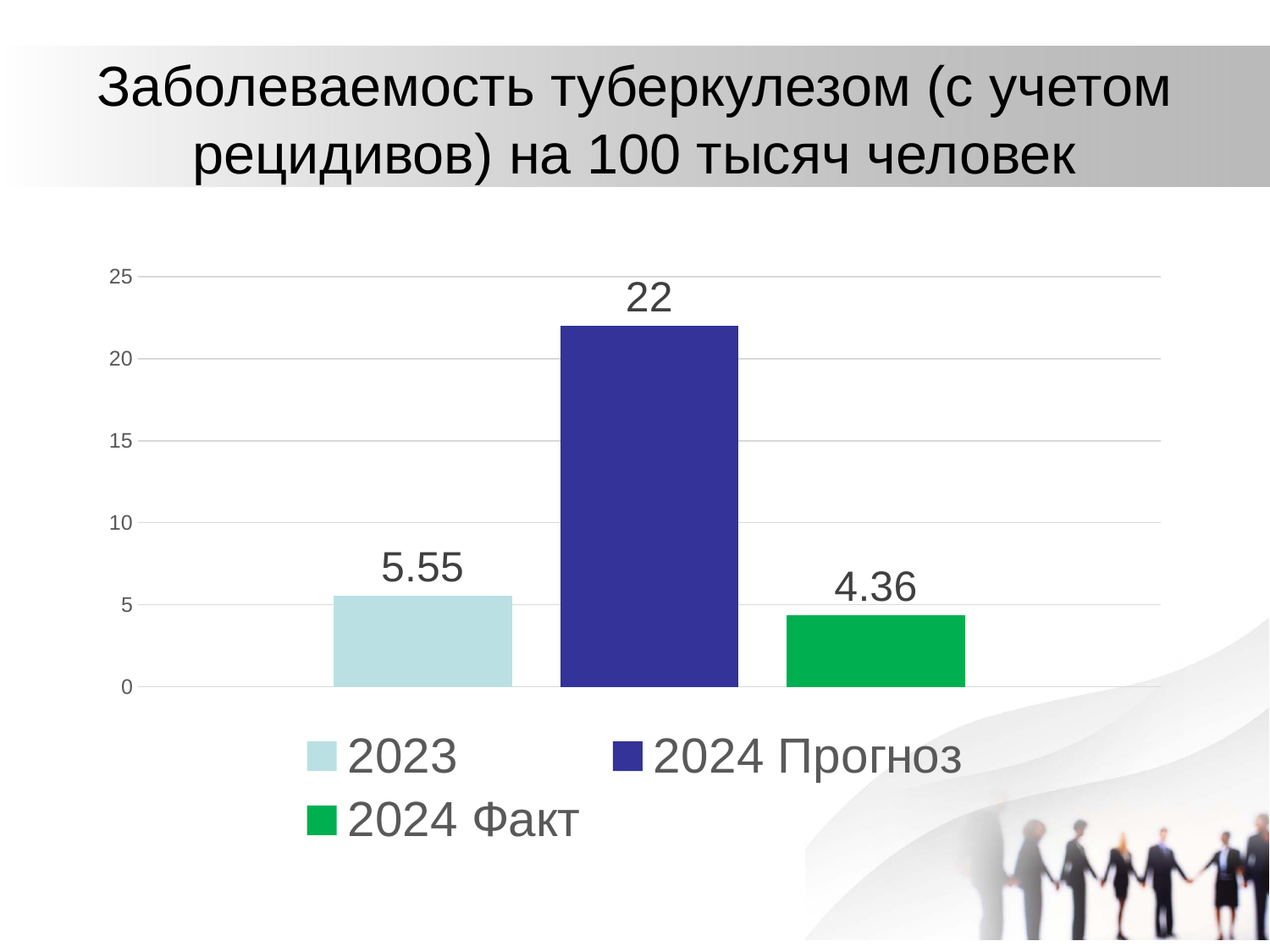
Which series has the highest value? 2024 Прогноз Is the value for 2024 Прогноз greater or less than 20? greater Which series has the lowest value? 2024 Факт What is the difference between the 2024 Прогноз value and the 2024 Факт value? 17.64 How many series does the legend list? 3 What is the value for 2023? 5.55 What is the difference between the 2023 value and the 2024 Факт value? 1.19 What is the value for 2024 Факт? 4.36 What kind of chart is shown on the slide? Bar chart Which is larger, the value for 2023 or the value for 2024 Факт? 2023 What is the value for 2024 Прогноз? 22 What colour is the bar for 2024 Факт? Green